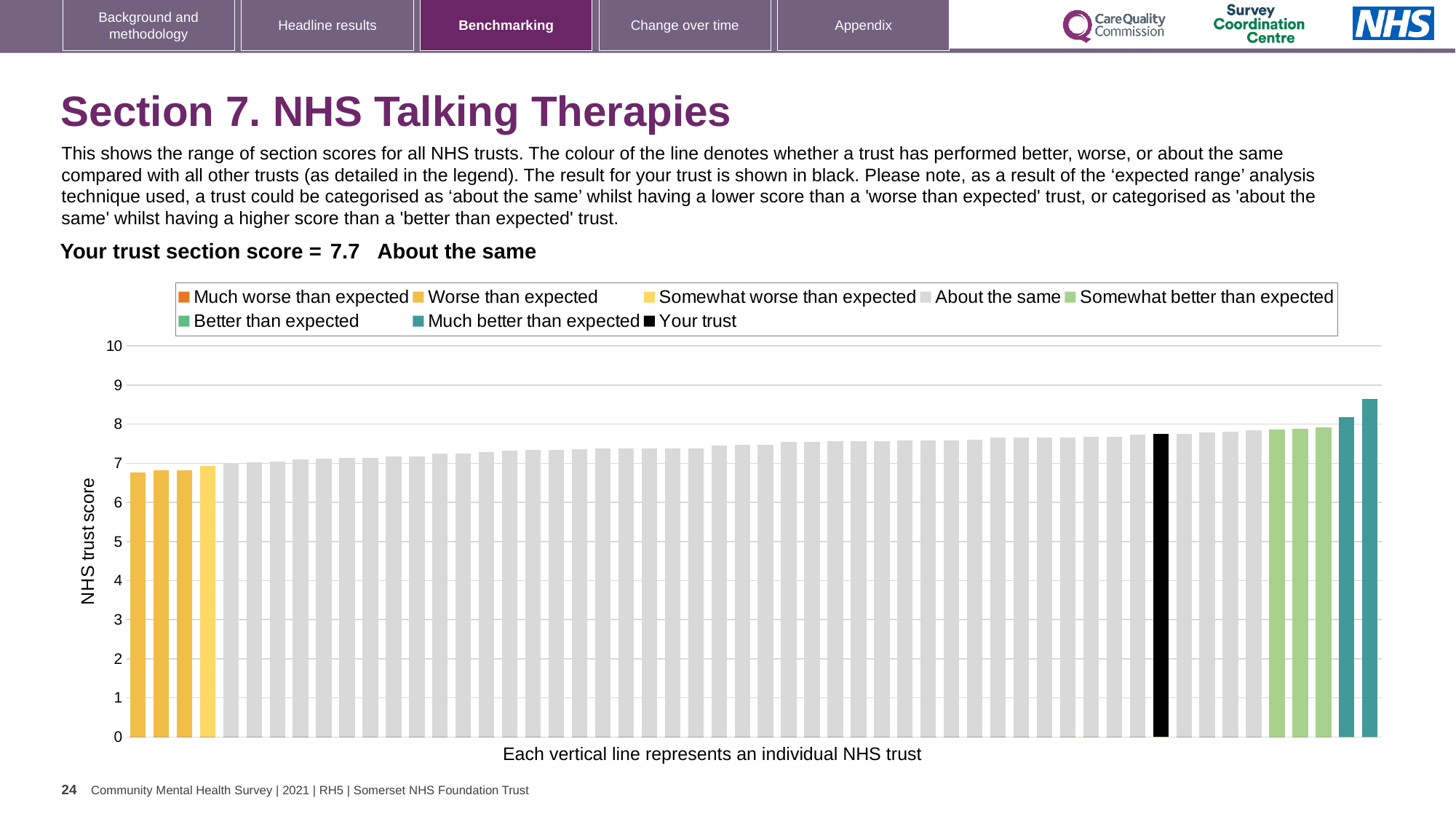
How many entries does the chart legend list? 8 Is the value of the tallest bar in the chart greater or less than 8? greater What is the label on the vertical axis of the chart? NHS trust score Do the bar values rise or fall from left to right along the x axis? rise Is the black 'Your trust' bar higher or lower than the rightmost teal bar? lower Is the value of the leftmost bar in the chart greater or less than 7? less What is the section score for your trust shown on the slide? 7.7 Which category is your trust's section score placed in? About the same Which legend category does the tallest bar belong to? Much better than expected Is the value of the black 'Your trust' bar greater or less than 7? greater How many bars are coloured as 'Much better than expected'? 2 What kind of chart is shown on the slide? bar chart